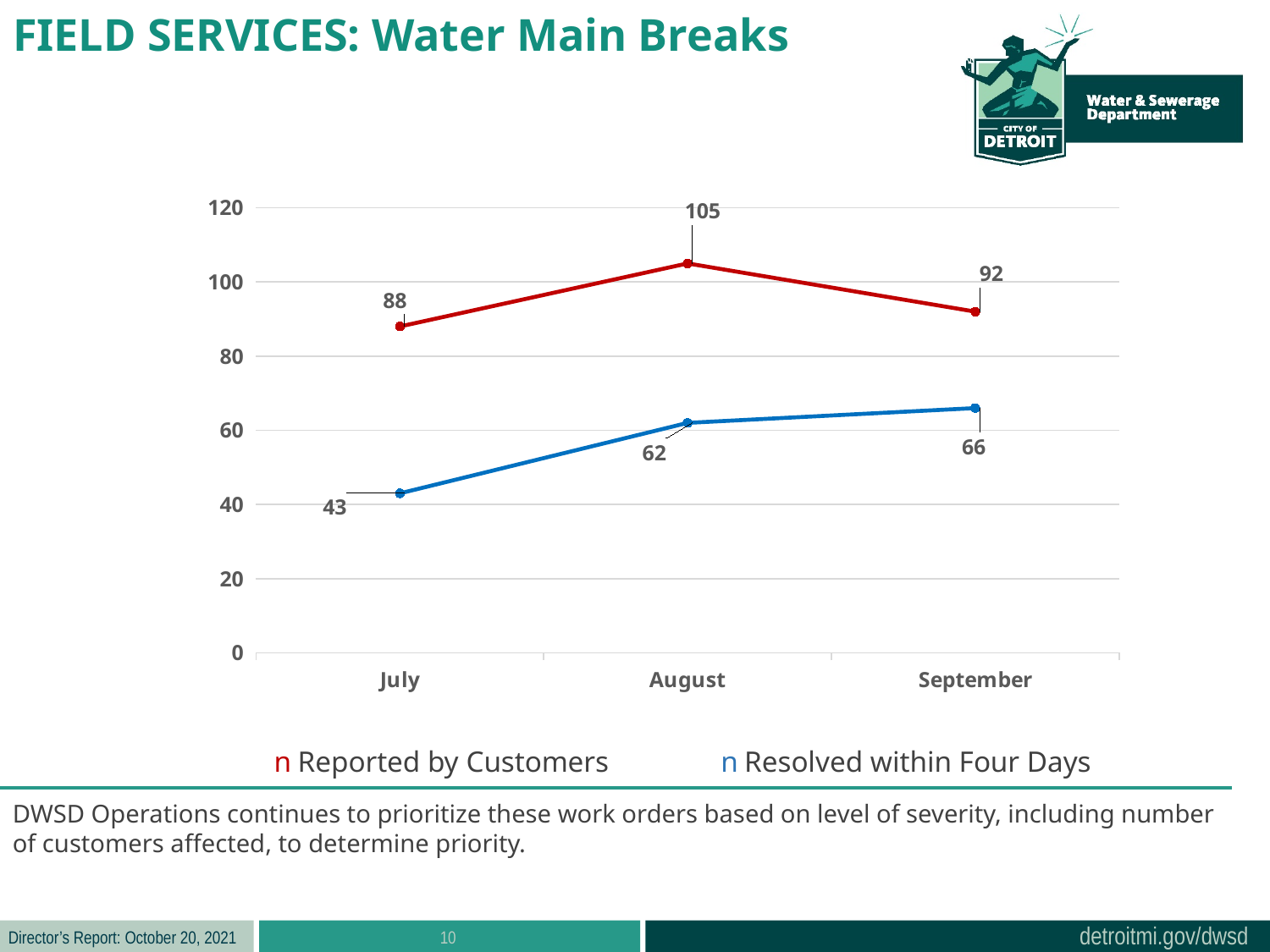
What is the value for Reported by Customers in September? 92 What kind of chart is shown on the slide? line chart Does Resolved within Four Days rise or fall from July to September? rise Is the value for Resolved within Four Days in August greater or less than 80? less What is the difference between Reported by Customers and Resolved within Four Days in September? 26 What is the value for Resolved within Four Days in July? 43 Which is larger in July: Reported by Customers or Resolved within Four Days? Reported by Customers In which month is Resolved within Four Days lowest? July How many series does the legend list? 2 What is the value for Reported by Customers in August? 105 How many months are shown on the x axis? 3 In which month is Reported by Customers highest? August